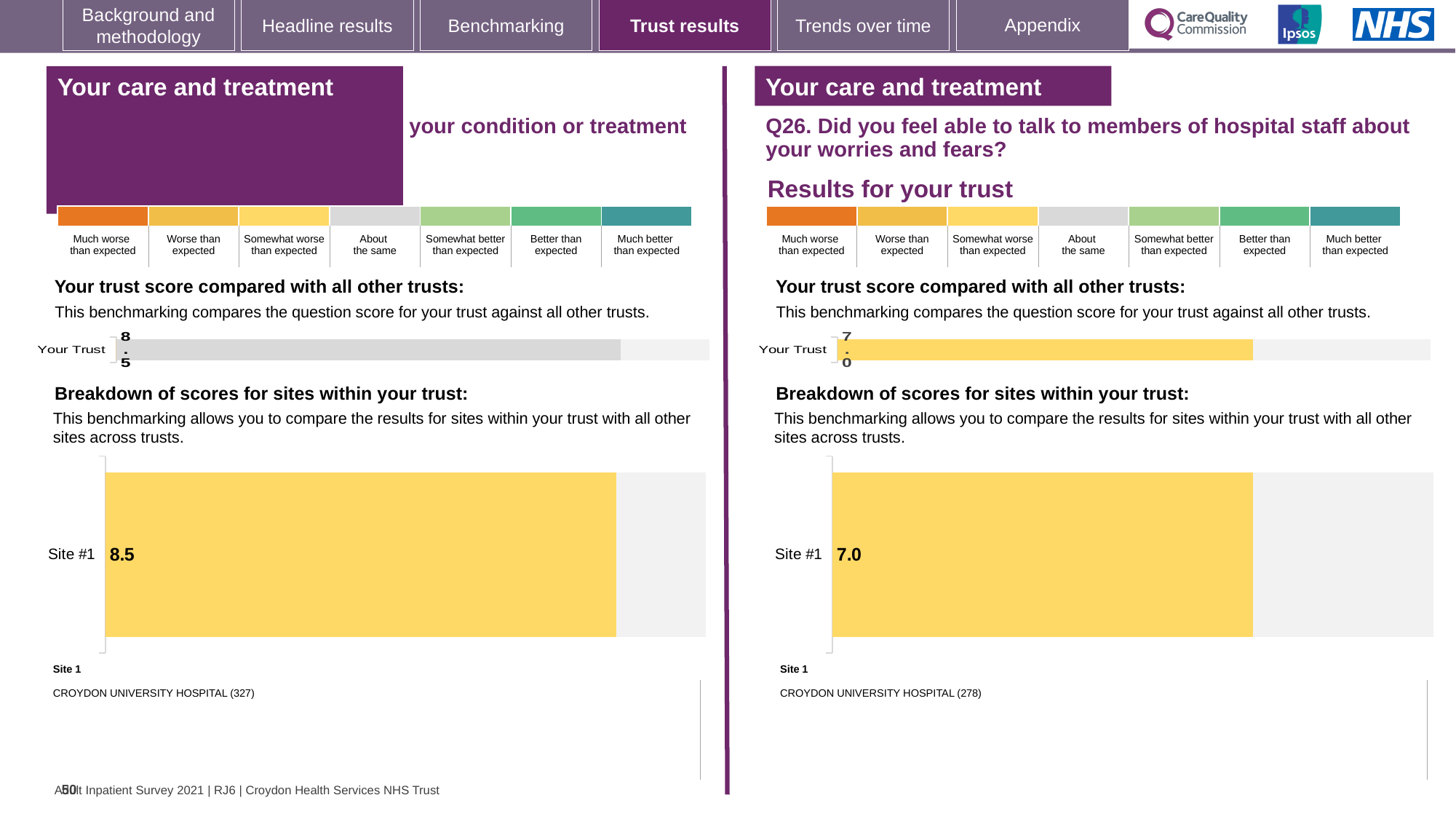
What is the difference between the 'Your Trust' score on the left half of the slide and the 'Your Trust' score on the right half (Q26)? 1.5 What type of chart is used to show the Site #1 score in the left-hand 'Breakdown of scores for sites within your trust' section? Bar chart What colour is the 'Your Trust' bar in the left-hand 'Your trust score compared with all other trusts' chart? Grey On the right half of the slide (Q26), what score is shown for Site #1 in the 'Breakdown of scores for sites within your trust' chart? 7.0 Which Site #1 score is larger: the one in the left-hand site breakdown chart or the one in the right-hand (Q26) site breakdown chart? The left-hand chart (8.5) Which site is listed as Site 1 beneath the right-hand (Q26) site breakdown chart? CROYDON UNIVERSITY HOSPITAL (278) On the left half of the slide, what is the score shown for 'Your Trust' in the 'Your trust score compared with all other trusts' chart? 8.5 How many sites are plotted in the 'Breakdown of scores for sites within your trust' chart on the right half of the slide (Q26)? 1 On the right half of the slide (Q26), what is the score shown for 'Your Trust' in the 'Your trust score compared with all other trusts' chart? 7.0 What is the difference between the Site #1 score in the left-hand site breakdown chart and the Site #1 score in the right-hand (Q26) site breakdown chart? 1.5 On the left half of the slide, what score is shown for Site #1 in the 'Breakdown of scores for sites within your trust' chart? 8.5 What colour is the Site #1 bar in the right-hand (Q26) 'Breakdown of scores for sites within your trust' chart? Yellow